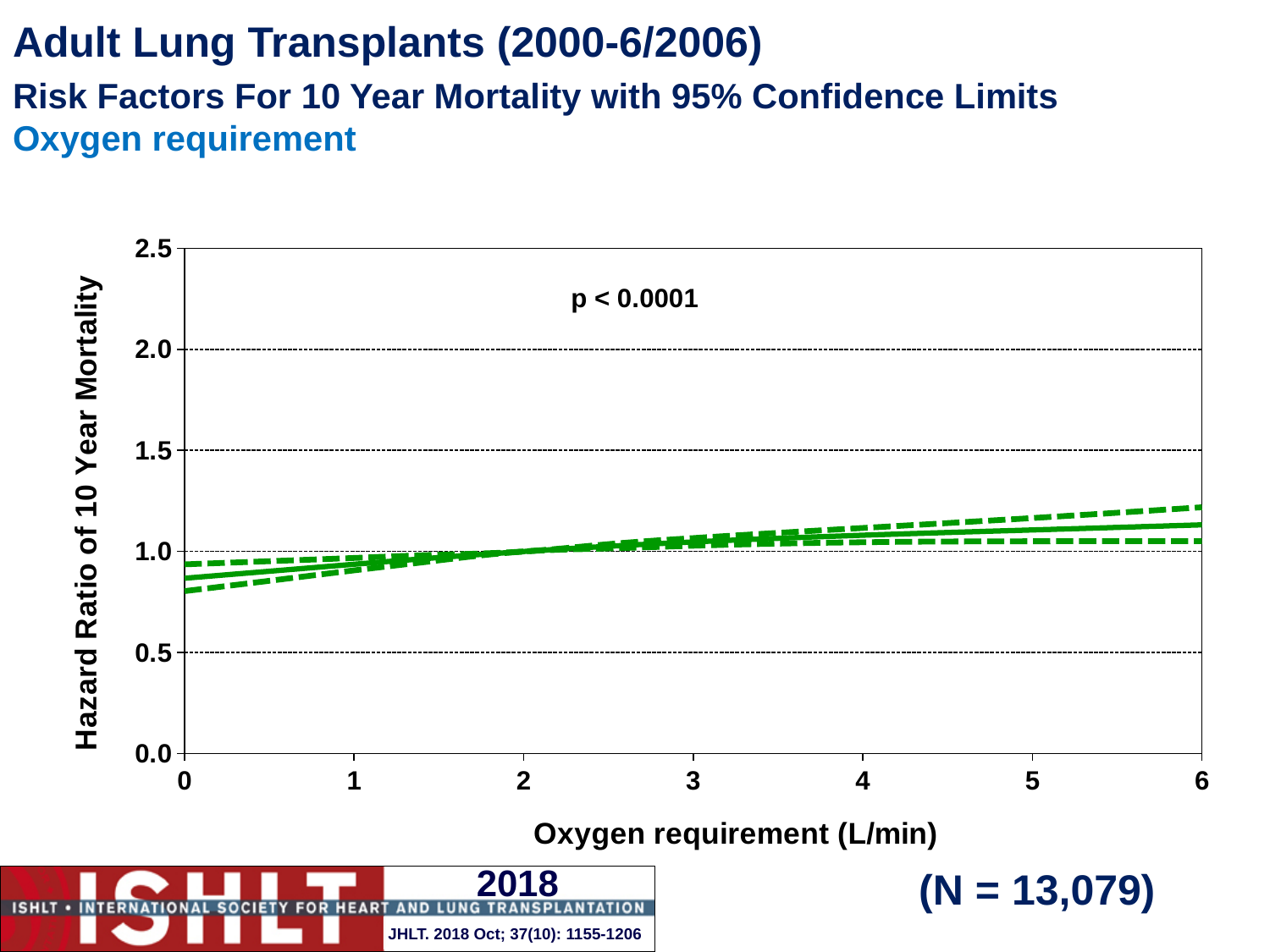
What p-value is printed on the chart? p < 0.0001 Is the lower 95% confidence limit at an oxygen requirement of 0 L/min greater or less than 0.5? greater Is the hazard ratio (solid line) at an oxygen requirement of 6 L/min greater or less than 1.0? greater Is the hazard ratio (solid line) at an oxygen requirement of 0 L/min greater or less than 1.0? less How many lines (solid and dashed) are plotted on the chart? 3 What is the label of the y axis? Hazard Ratio of 10 Year Mortality What is the highest value shown on the y axis? 2.5 What is the highest value shown on the x axis (oxygen requirement)? 6 Does the hazard ratio of 10 year mortality rise or fall as oxygen requirement increases from 0 to 6 L/min? rise What kind of chart is shown on the slide? line chart Is the hazard ratio (solid line) higher at 6 L/min or at 0 L/min of oxygen requirement? 6 L/min